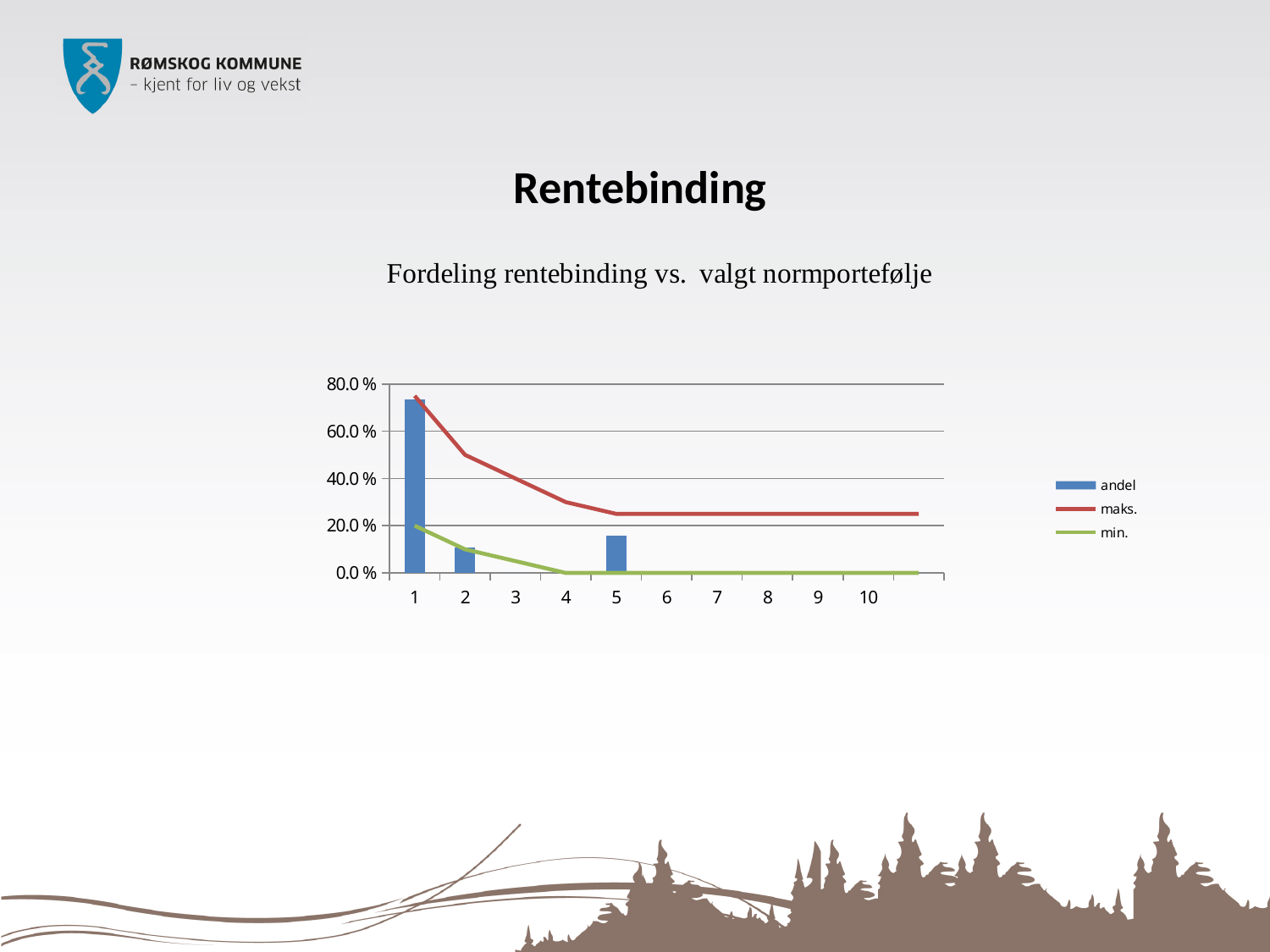
Is the 'andel' value for category 1 greater or less than 60.0 %? greater Is the 'min.' value for category 1 greater or less than 40.0 %? less Is the 'maks.' value for category 2 greater or less than 40.0 %? greater How many series does the chart legend list? 3 Does the 'maks.' line rise or fall from category 1 to category 5? fall What are the series names listed in the chart legend? andel, maks., min. What kind of chart is shown on the slide? A combined bar and line chart How many categories are labelled on the x axis of the chart? 10 Which has the larger 'andel' value, category 1 or category 5? 1 Which category has the highest value for the 'andel' series? 1 What is the title of the chart? Fordeling rentebinding vs. valgt normportefølje